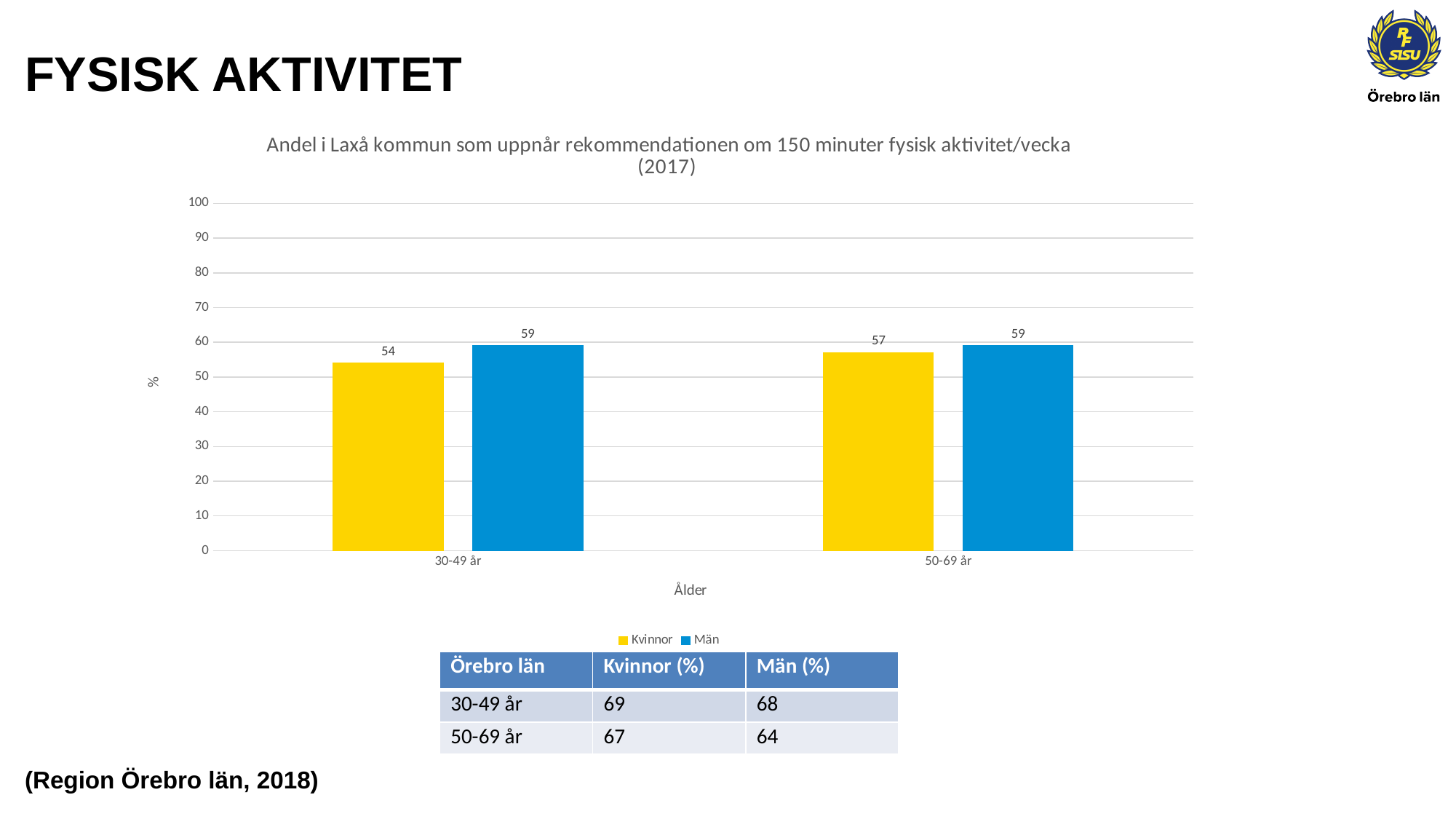
What colour are the Kvinnor bars? yellow How many age categories are shown on the x axis? 2 Is the value for Män in the 30-49 år category greater or less than 50? greater Which is larger, Kvinnor in 30-49 år or Kvinnor in 50-69 år? Kvinnor in 50-69 år What is the value for Kvinnor in the 50-69 år category? 57 What is the difference between Män and Kvinnor in the 30-49 år category? 5 Which series has the lowest value in the 30-49 år category? Kvinnor How many series does the legend list? 2 What is the difference between Kvinnor in 50-69 år and Kvinnor in 30-49 år? 3 What is the value for Män in the 50-69 år category? 59 What is the value for Kvinnor in the 30-49 år category? 54 What kind of chart is shown on the slide? bar chart